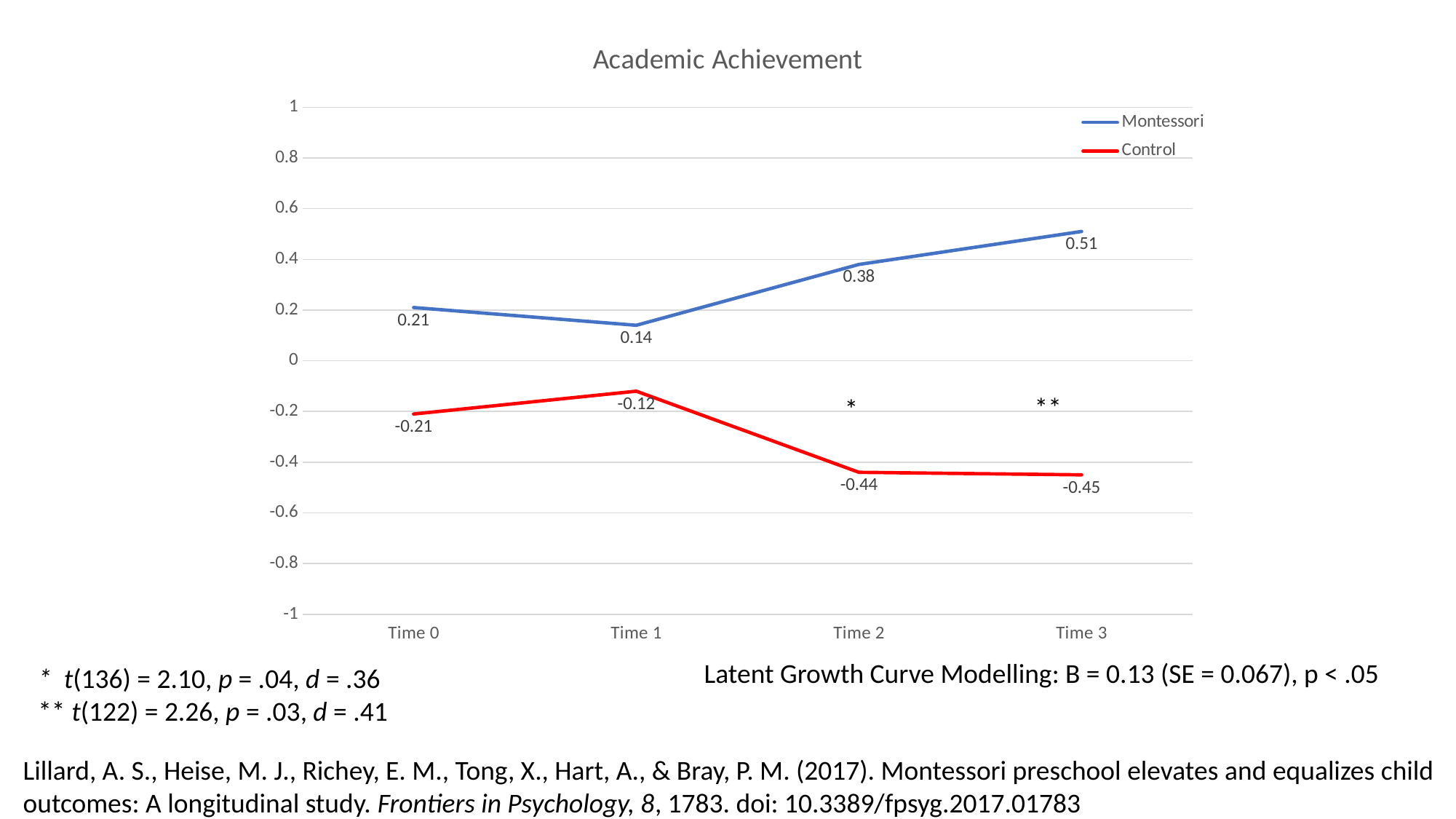
What is the title of the chart? Academic Achievement What is the Control value at Time 0? -0.21 At which time point is the Montessori value highest? Time 3 What is the Montessori value at Time 3? 0.51 What is the Montessori value at Time 1? 0.14 How many time points are plotted on the x axis? 4 How many series does the legend list? 2 At which time point is the Control value highest? Time 1 Which series has the larger value at Time 2, Montessori or Control? Montessori What is the Control value at Time 2? -0.44 What is the difference between the Montessori and Control values at Time 3? 0.96 What kind of chart is shown? Line chart